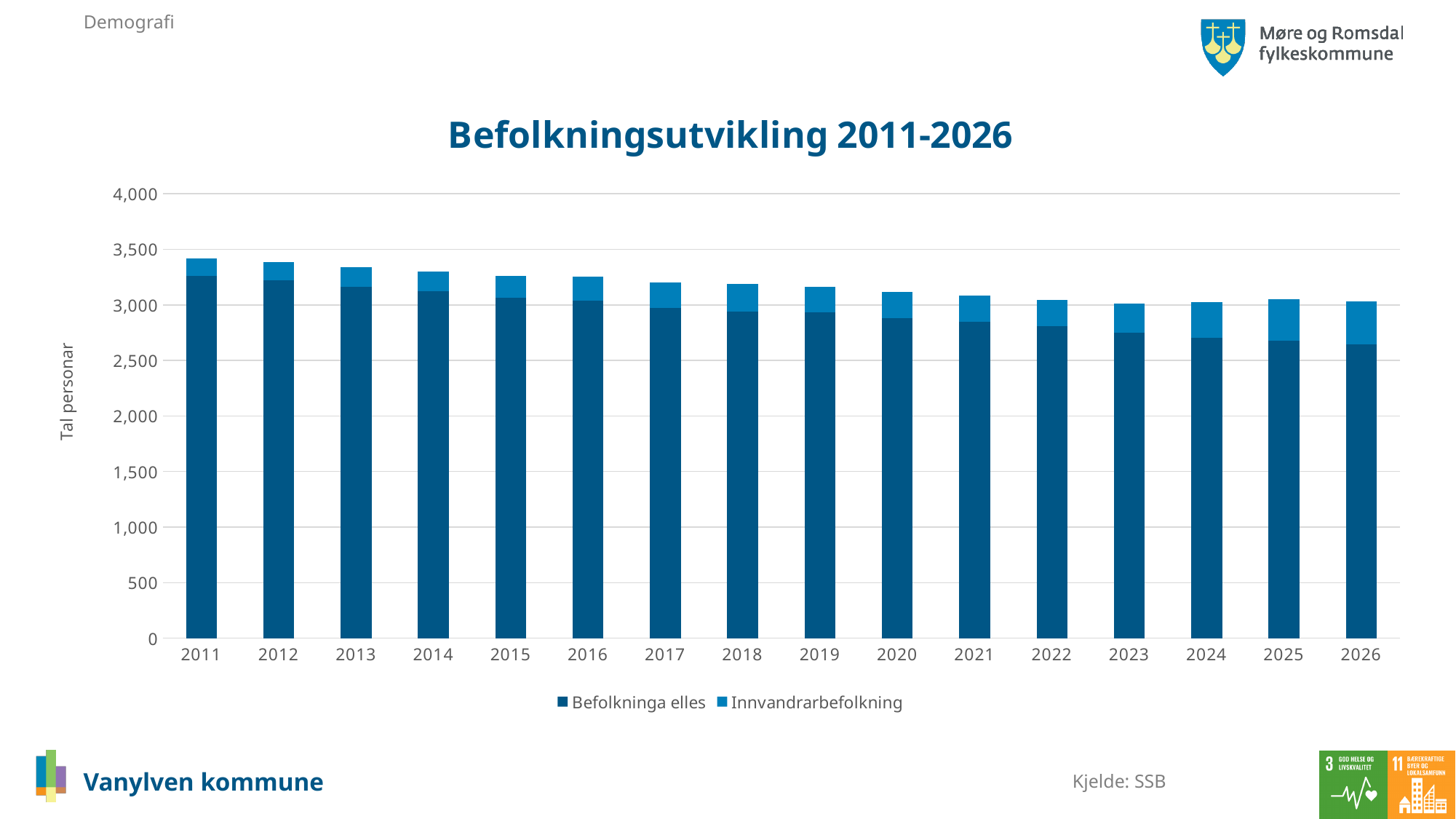
What kind of chart is shown on the slide? Stacked bar chart Which is larger, the total bar for 2011 or the total bar for 2026? 2011 How many series does the legend list? 2 Is the total value for 2011 greater or less than 3,500? less What is the label on the vertical axis? Tal personar Does the Befolkninga elles series rise or fall from 2011 to 2026? Fall What is the title of the chart? Befolkningsutvikling 2011-2026 Is the total value for 2011 greater or less than 3,000? greater How many years are shown on the x axis? 16 Which year has the highest total bar? 2011 Is the value of Befolkninga elles for 2026 greater or less than 3,000? less